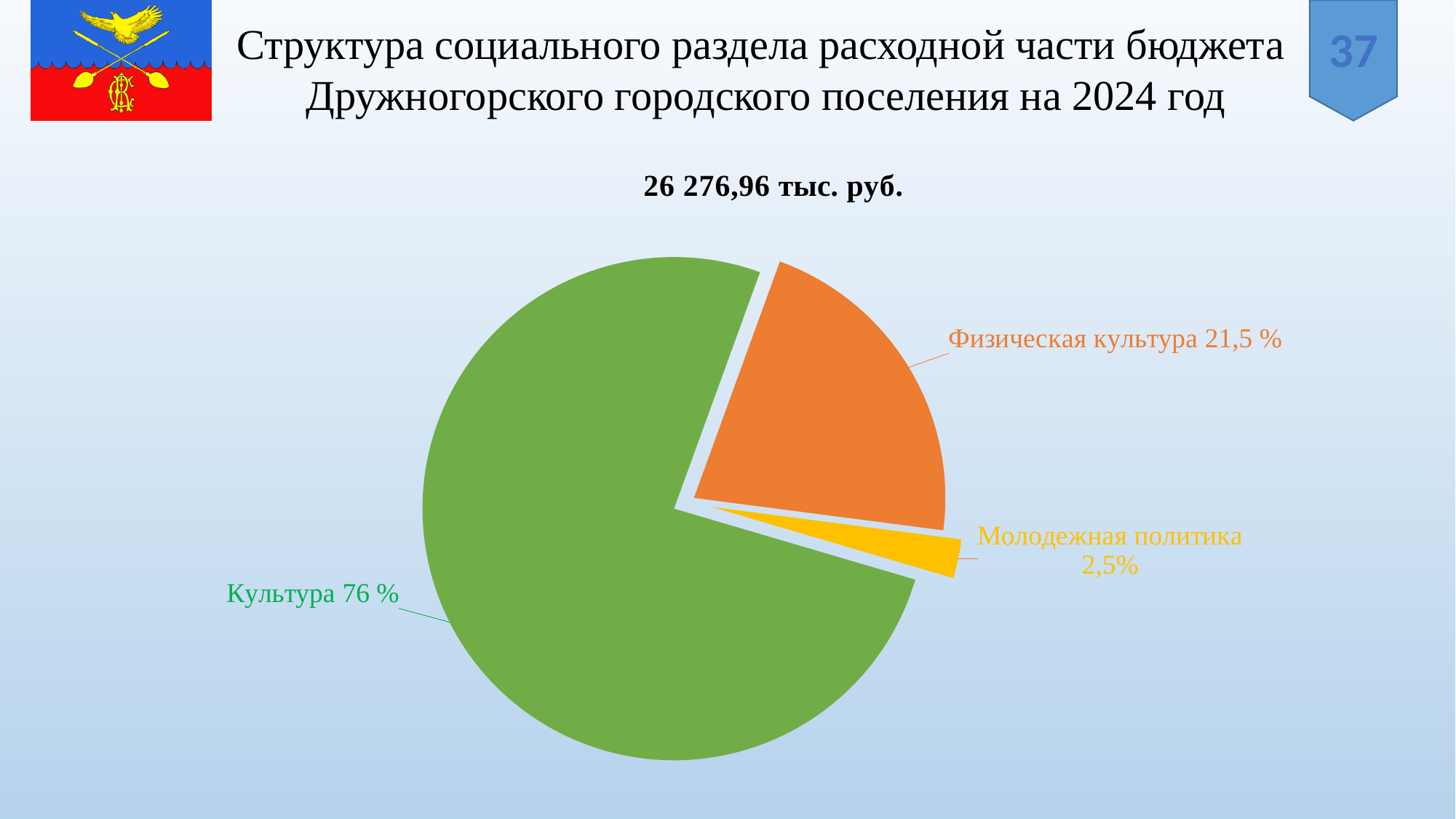
What total amount is printed above the pie chart? 26 276,96 тыс. руб. What is the difference in percentage points between the Физическая культура share and the Молодежная политика share? 19 How many slices does the pie chart have? 3 What share of the pie does Культура have? 76 % What is the difference in percentage points between the Культура share and the Физическая культура share? 54,5 Which category has the largest slice of the pie? Культура What share of the pie does Молодежная политика have? 2,5% What kind of chart is shown on the slide? Pie chart What colour is the Культура slice of the pie? Green Which is larger, the share for Физическая культура or the share for Молодежная политика? Физическая культура What share of the pie does Физическая культура have? 21,5 % Which category has the smallest slice of the pie? Молодежная политика